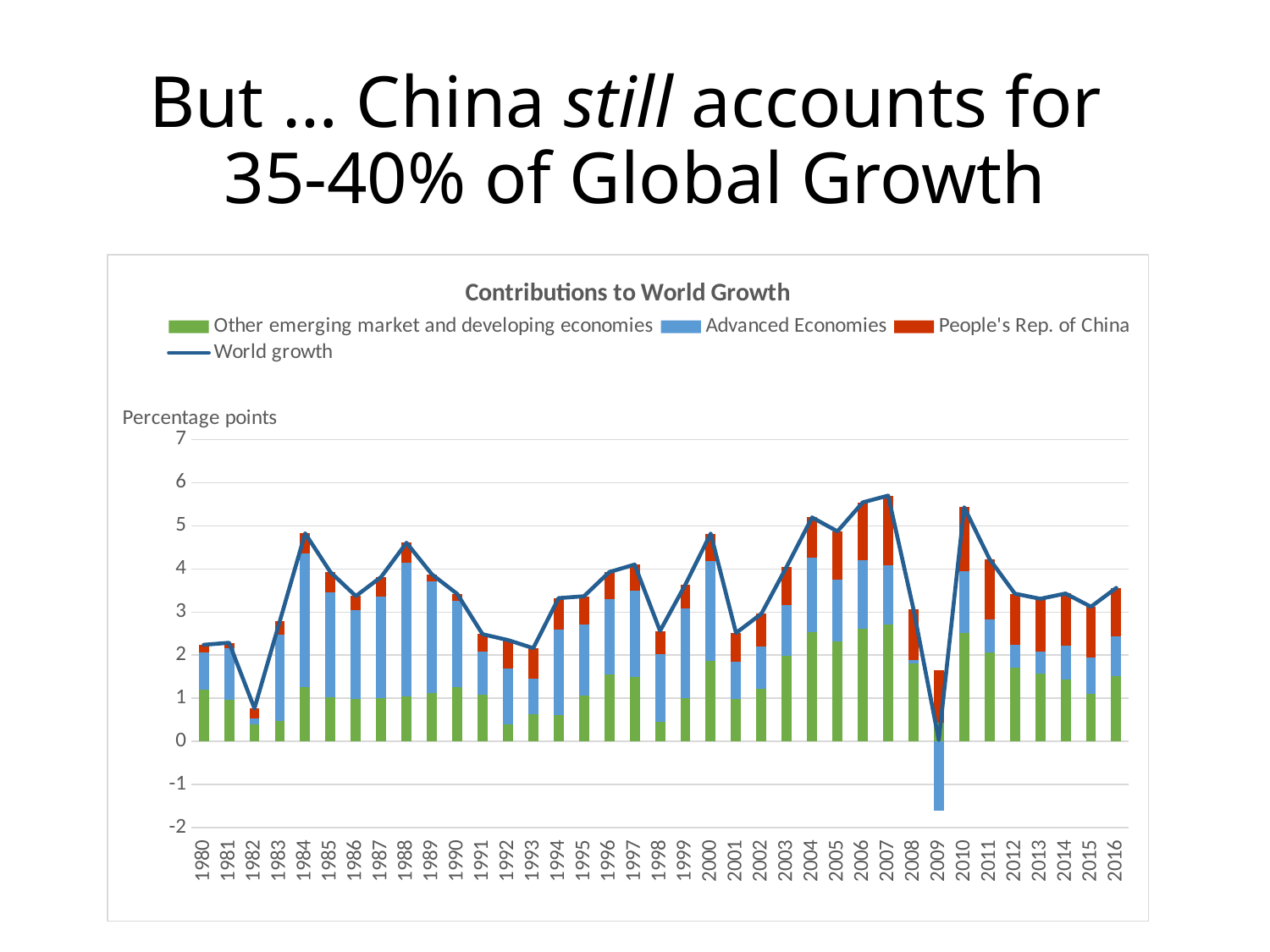
Is the World growth value for 1982 greater or less than 1? less In which year is the World growth line at its lowest? 2009 Is the World growth value for 1984 greater or less than 4? greater How many series does the legend list? 4 Which year has the higher World growth value, 1984 or 1982? 1984 Is the World growth value for 2007 greater or less than 5? greater How many years are shown on the x axis? 37 In which year is the Advanced Economies contribution negative? 2009 What is the title of the chart? Contributions to World Growth What kind of chart is shown on the slide? Bar chart with a line overlay What unit is shown on the vertical axis label? Percentage points